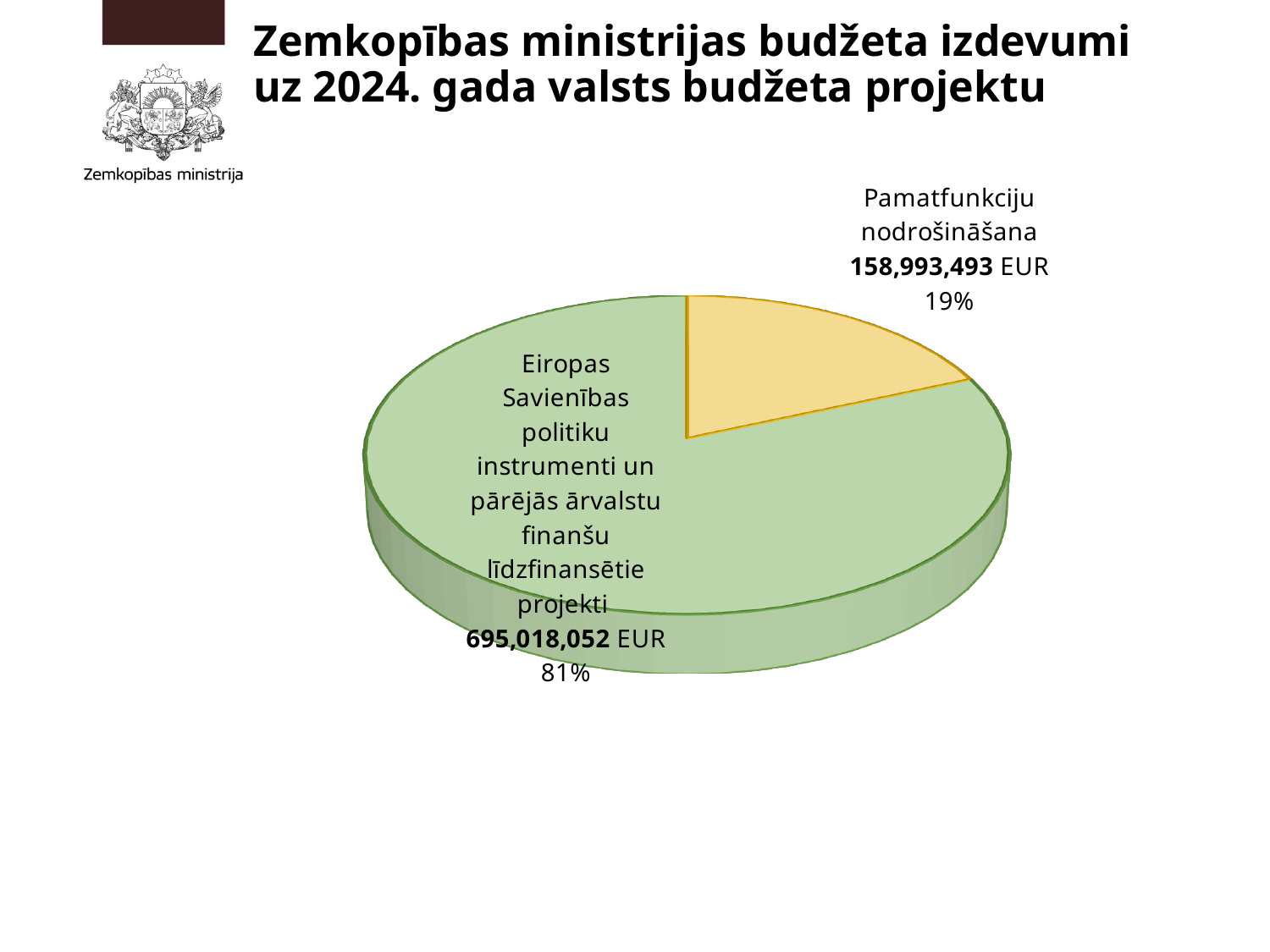
What is the value for Eiropas Savienības politiku instrumenti un pārējās ārvalstu finanšu līdzfinansētie projekti? 695,018,052 EUR What share of the pie does Eiropas Savienības politiku instrumenti un pārējās ārvalstu finanšu līdzfinansētie projekti represent? 81% What kind of chart is shown on the slide? Pie chart What is the difference in EUR between the two slices? 536,024,559 EUR Which slice is the largest? Eiropas Savienības politiku instrumenti un pārējās ārvalstu finanšu līdzfinansētie projekti What colour is the Pamatfunkciju nodrošināšana slice? Yellow What is the total of the two slices in EUR? 854,011,545 EUR What share of the pie does Pamatfunkciju nodrošināšana represent? 19% Which is larger: Pamatfunkciju nodrošināšana or Eiropas Savienības politiku instrumenti un pārējās ārvalstu finanšu līdzfinansētie projekti? Eiropas Savienības politiku instrumenti un pārējās ārvalstu finanšu līdzfinansētie projekti What is the value for Pamatfunkciju nodrošināšana? 158,993,493 EUR How many slices does the pie chart have? 2 Which slice is the smallest? Pamatfunkciju nodrošināšana